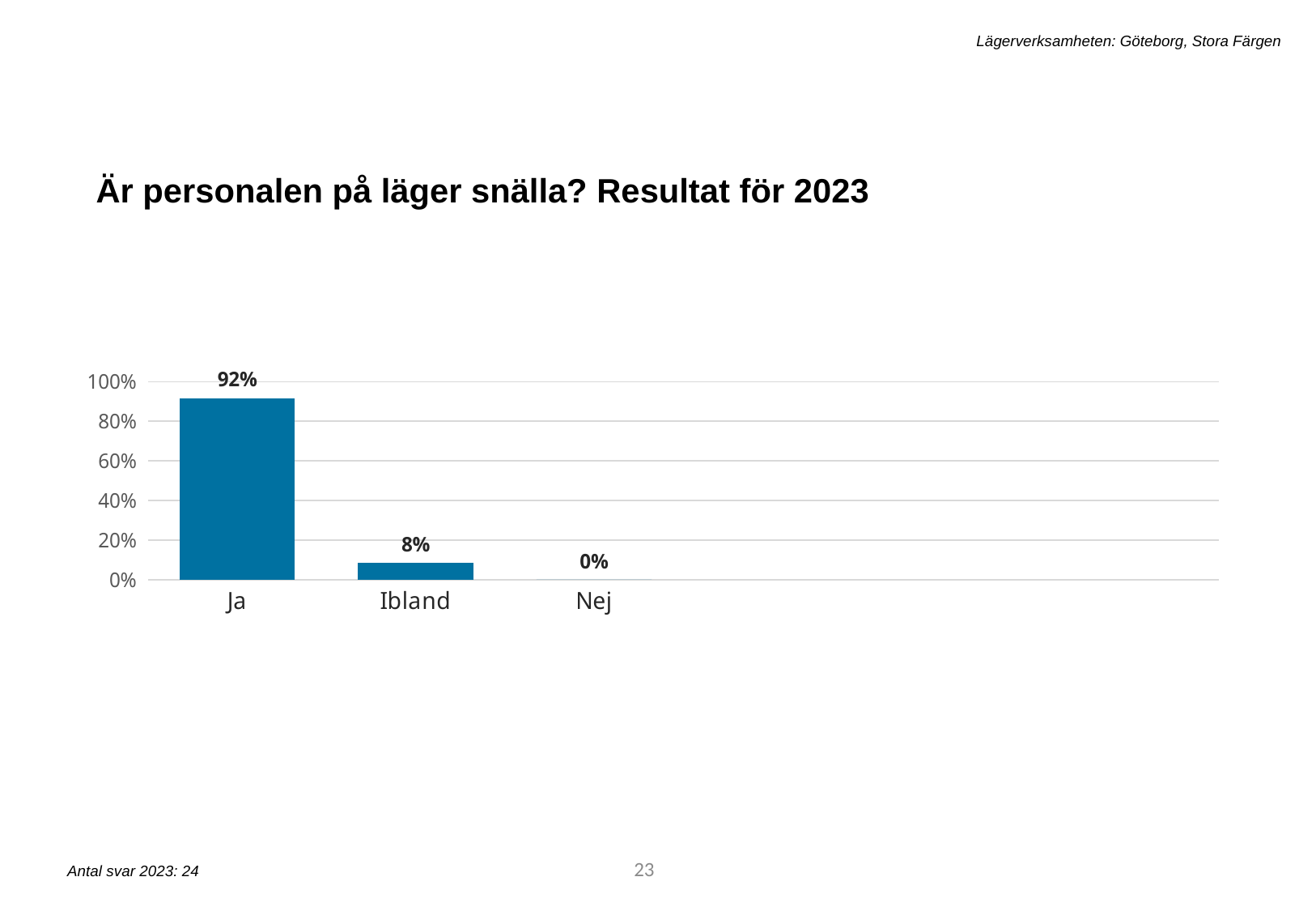
What is the difference between the values for Ja and Ibland? 84% Which is larger, the value for Ibland or the value for Nej? Ibland How many categories are shown on the x axis? 3 Which category has the highest value? Ja What is the value for Nej? 0% Is the value for Ja greater or less than 80%? greater What is the value for Ja? 92% Is the value for Ibland greater or less than 20%? less What is the value for Ibland? 8% Which category has the lowest value? Nej What is the title of the slide above the chart? Är personalen på läger snälla? Resultat för 2023 What kind of chart is shown on the slide? bar chart